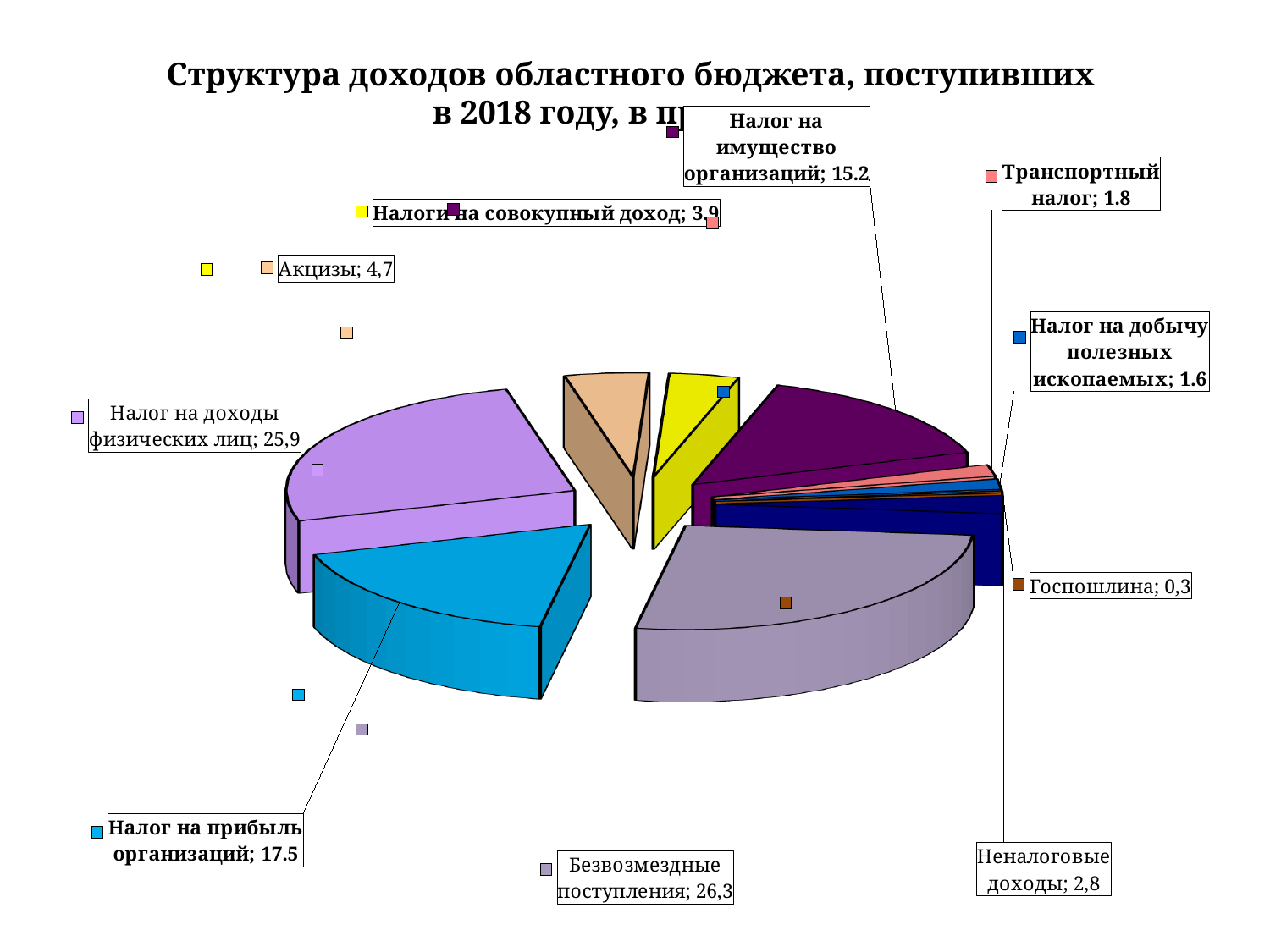
What is the value shown for Госпошлина? 0,3 What is the value shown for Акцизы? 4,7 What is the value shown for Налог на доходы физических лиц? 25,9 What kind of chart is shown on the slide? Pie chart Which category has the smallest value in the pie chart? Госпошлина What is the value shown for Налог на имущество организаций? 15.2 Which category has the largest value in the pie chart? Безвозмездные поступления What is the difference between the values for Налог на прибыль организаций and Налог на имущество организаций? 2.3 What is the value shown for Налог на прибыль организаций? 17.5 How many categories are labelled in the pie chart? 10 What is the value shown for Безвозмездные поступления? 26,3 Which is larger: the value for Транспортный налог or the value for Налог на добычу полезных ископаемых? Транспортный налог